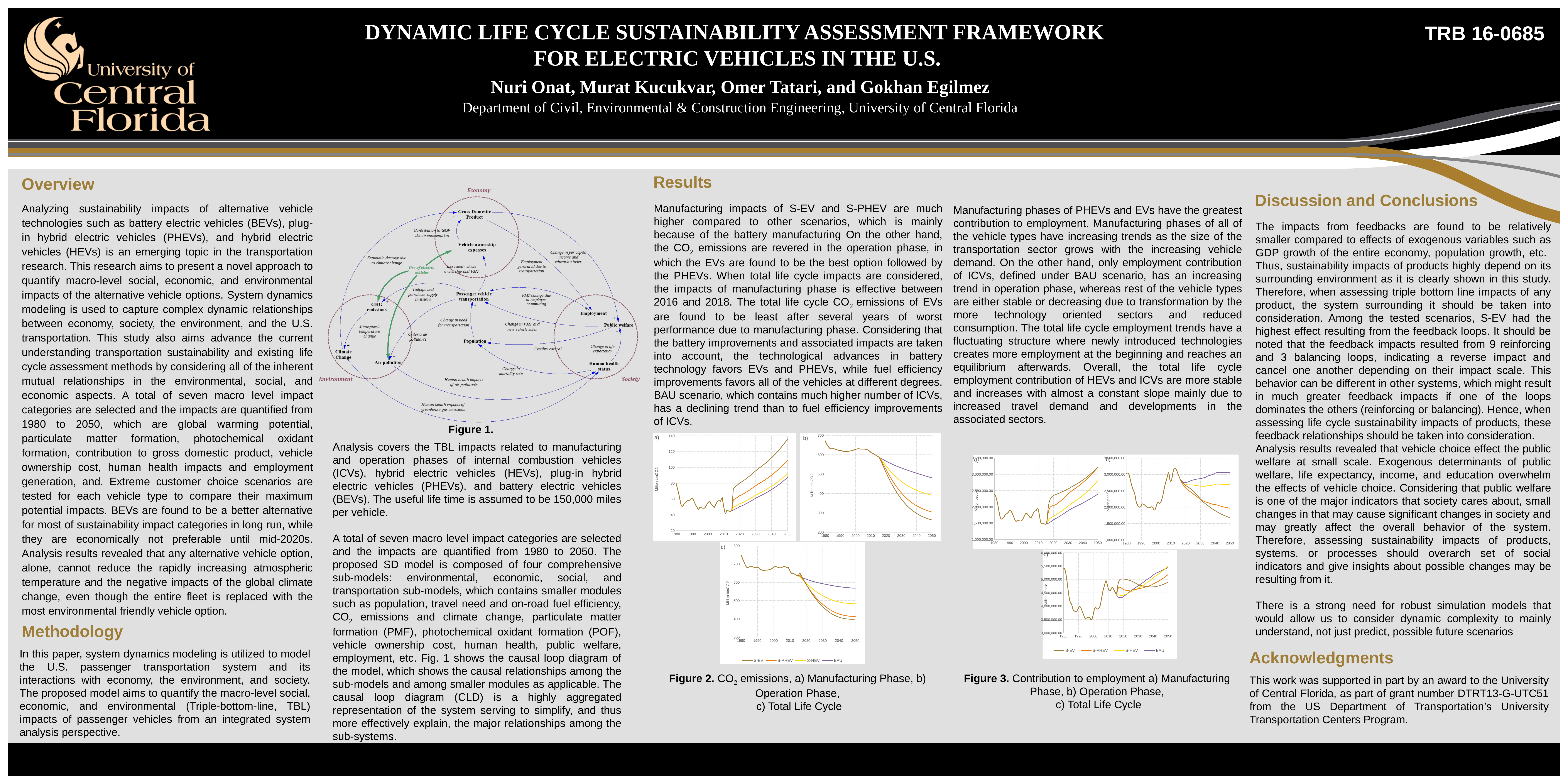
In Figure 2 panel a) Manufacturing Phase, which series is highest at 2050? S-EV How many series does the legend of Figure 2 list? 4 In Figure 2 panel a) Manufacturing Phase, is the value for S-EV at 2050 greater or less than 120? greater In Figure 2 panel b) Operation Phase, do the CO2 emission lines rise or fall between 2020 and 2050? fall In Figure 2 panel a) Manufacturing Phase, do the lines rise or fall between 2020 and 2050? rise In Figure 2 panel c) Total Life Cycle, is the value for S-EV at 2050 greater or less than 500? less In Figure 2 panel b) Operation Phase, which series is highest at 2050? BAU In Figure 2, what kind of chart is panel a) Manufacturing Phase? line chart In Figure 2 panel b) Operation Phase, which series is lowest at 2050? S-EV How many chart panels does Figure 2 contain? 3 In Figure 2 panel c) Total Life Cycle, is the value for BAU at 2050 greater or less than 500? greater What are the series names listed in the legend of Figure 3? S-EV, S-PHEV, S-HEV, BAU